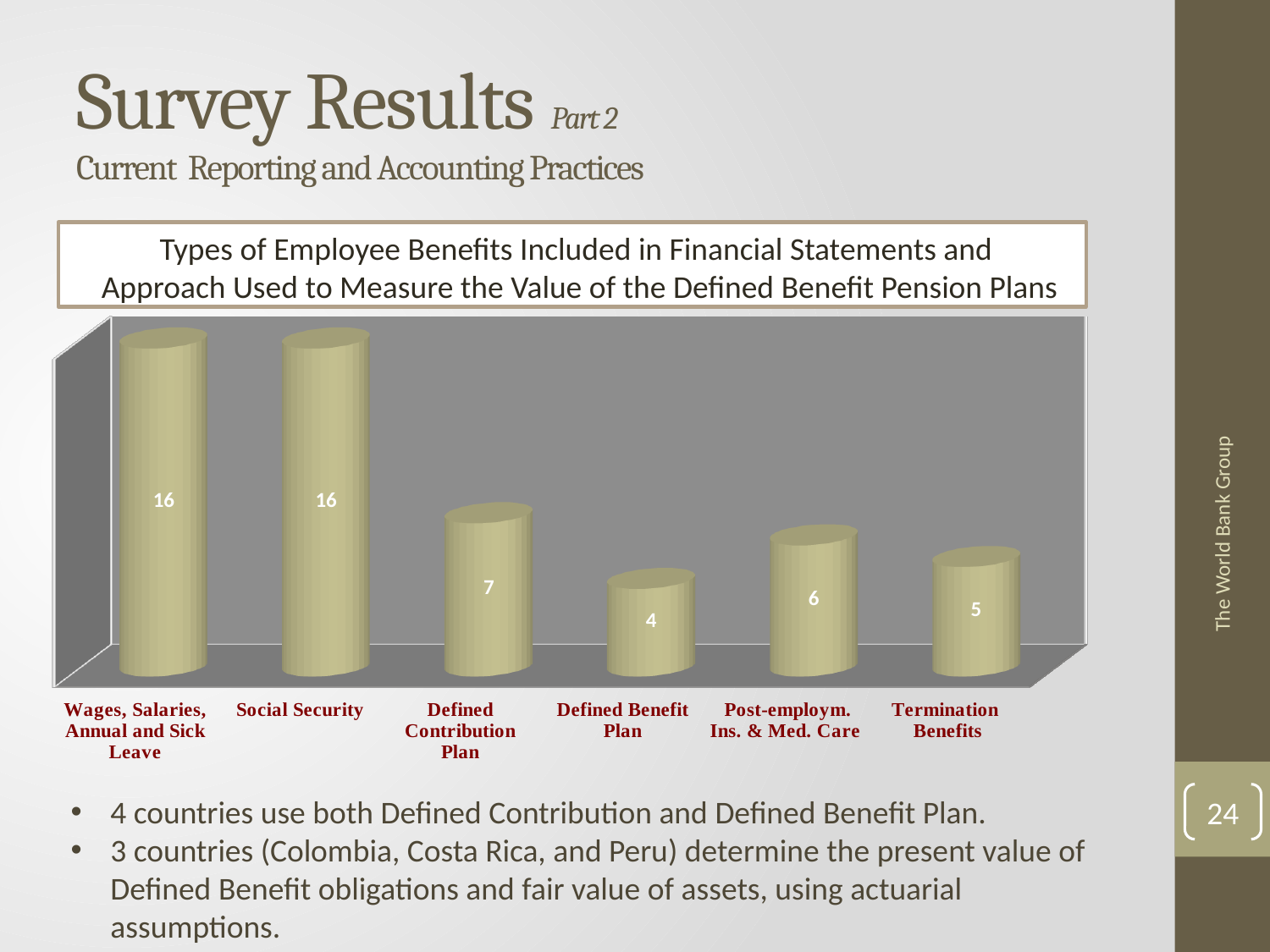
How many categories are shown in the chart? 6 Which is larger, the value for Defined Contribution Plan or the value for Defined Benefit Plan? Defined Contribution Plan What is the value for Defined Benefit Plan? 4 What kind of chart is shown on the slide? Bar chart What is the title of the chart? Types of Employee Benefits Included in Financial Statements and Approach Used to Measure the Value of the Defined Benefit Pension Plans What is the value for Social Security? 16 What is the value for Defined Contribution Plan? 7 What is the value for Post-employm. Ins. & Med. Care? 6 Which category has the lowest value? Defined Benefit Plan What is the difference between the values for Wages, Salaries, Annual and Sick Leave and Defined Contribution Plan? 9 What is the value for Termination Benefits? 5 What is the difference between the values for Post-employm. Ins. & Med. Care and Termination Benefits? 1